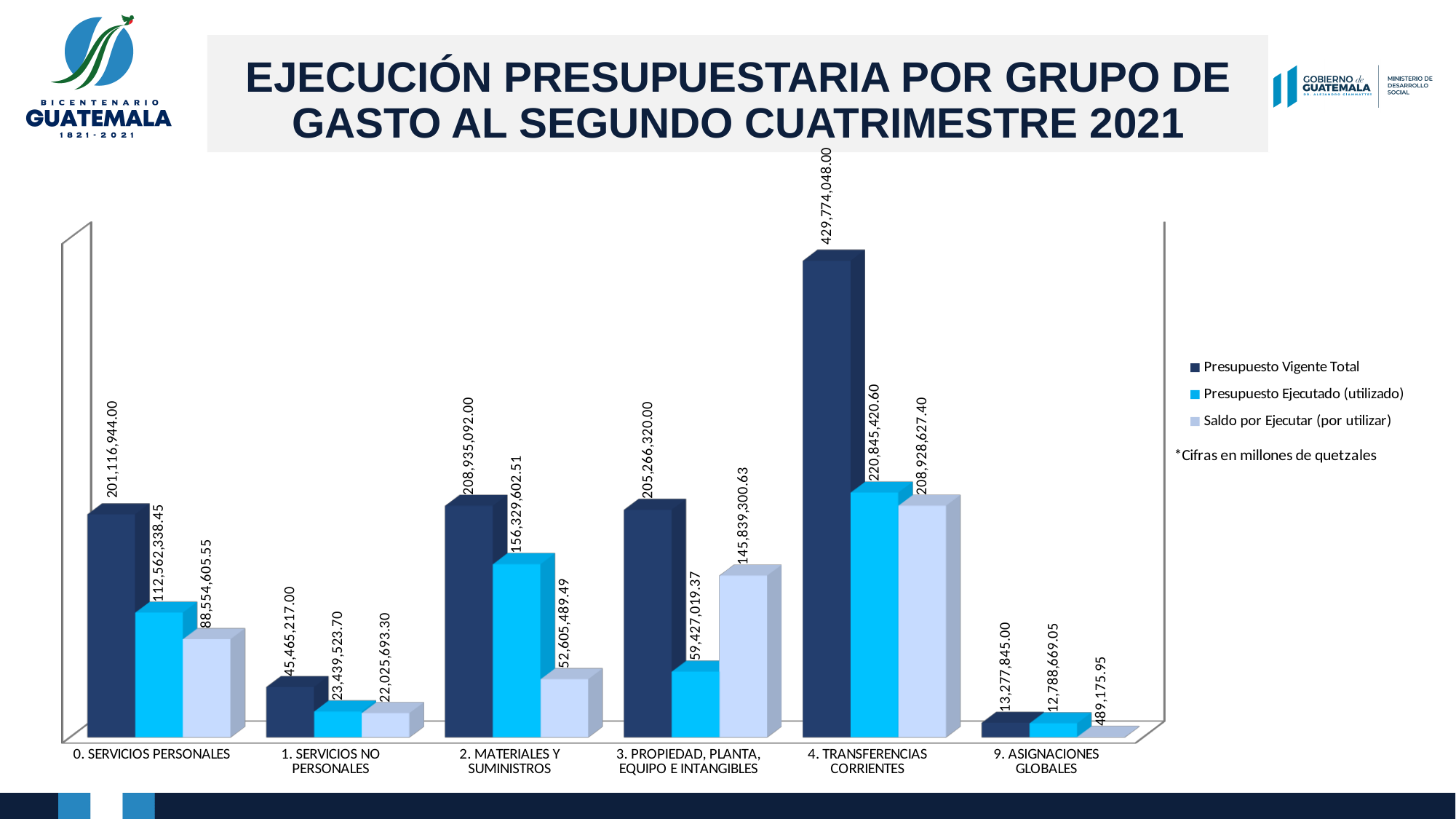
Which category has the highest Presupuesto Vigente Total? 4. TRANSFERENCIAS CORRIENTES How many series does the legend list? 3 What is the Presupuesto Ejecutado (utilizado) for 2. MATERIALES Y SUMINISTROS? 156,329,602.51 Which is larger: the Presupuesto Ejecutado (utilizado) for 2. MATERIALES Y SUMINISTROS or for 3. PROPIEDAD, PLANTA, EQUIPO E INTANGIBLES? 2. MATERIALES Y SUMINISTROS What kind of chart is shown on the slide? Bar chart Which category has the lowest Presupuesto Ejecutado (utilizado)? 9. ASIGNACIONES GLOBALES What is the Presupuesto Vigente Total for 4. TRANSFERENCIAS CORRIENTES? 429,774,048.00 What is the Saldo por Ejecutar (por utilizar) for 3. PROPIEDAD, PLANTA, EQUIPO E INTANGIBLES? 145,839,300.63 What is the Saldo por Ejecutar (por utilizar) for 9. ASIGNACIONES GLOBALES? 489,175.95 What is the difference between the Presupuesto Vigente Total of 2. MATERIALES Y SUMINISTROS and that of 3. PROPIEDAD, PLANTA, EQUIPO E INTANGIBLES? 3,668,772.00 How many expense group categories are shown on the x axis? 6 What is the difference between the Presupuesto Vigente Total and the Presupuesto Ejecutado (utilizado) for 4. TRANSFERENCIAS CORRIENTES? 208,928,627.40